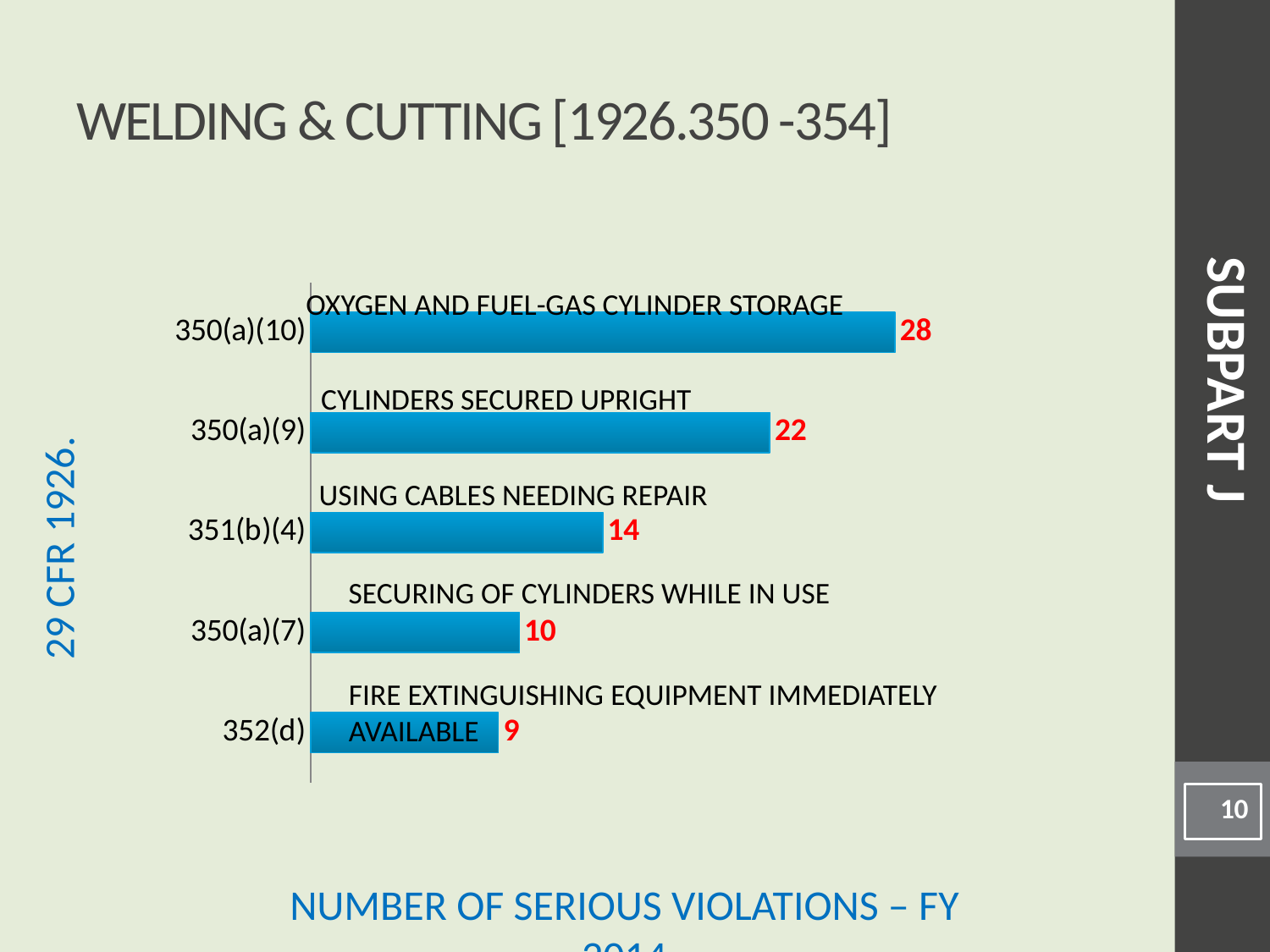
Which has more serious violations, 350(a)(9) or 351(b)(4)? 350(a)(9) What kind of chart is shown on the slide? Bar chart What is the value for 350(a)(7)? 10 What is the number of serious violations for 351(b)(4)? 14 What is the difference between the values for 351(b)(4) and 350(a)(7)? 4 What is the number of serious violations for 352(d)? 9 What is the description label on the bar for 350(a)(9)? CYLINDERS SECURED UPRIGHT What is the difference between the values for 350(a)(10) and 350(a)(9)? 6 Which category has the lowest number of serious violations? 352(d) Which category has the highest number of serious violations? 350(a)(10) How many categories are shown in the chart? 5 What is the number of serious violations for 350(a)(10)? 28